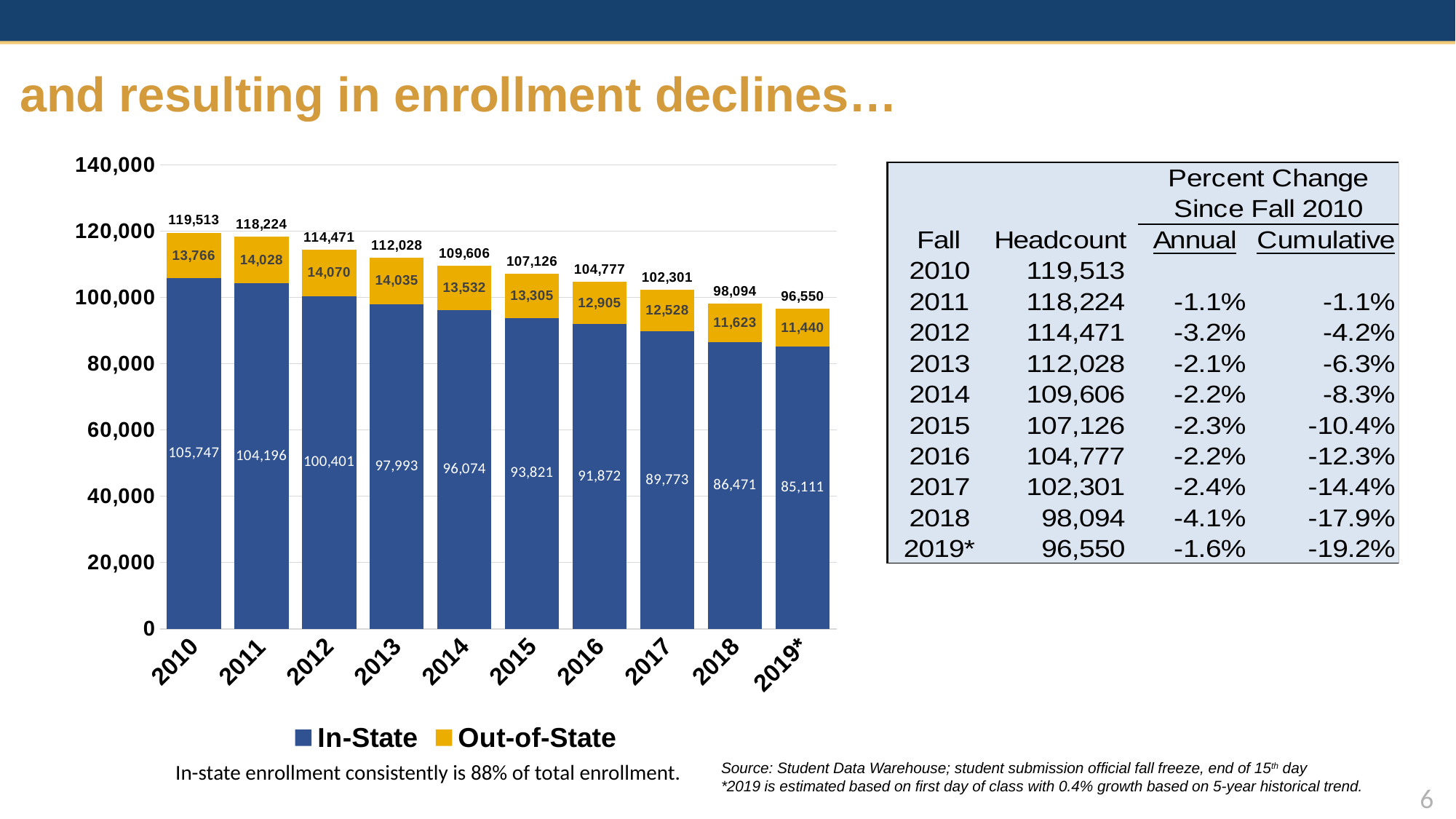
Which year has the lowest Out-of-State enrollment? 2019* How many years are shown on the x axis of the chart? 10 What is the total enrollment shown above the bar for 2018? 98,094 Do the total enrollment values rise or fall from 2010 to 2019*? fall What is the Out-of-State enrollment value for 2015? 13,305 What is the difference between the In-State values for 2010 and 2019*? 20,636 Which is larger, the Out-of-State value for 2012 or for 2013? 2012 What kind of chart is shown on the slide? stacked bar chart Which year has the highest total enrollment? 2010 What is the In-State enrollment value for 2010? 105,747 How many series does the legend list? 2 Is the total enrollment for 2019* greater or less than 100,000? less